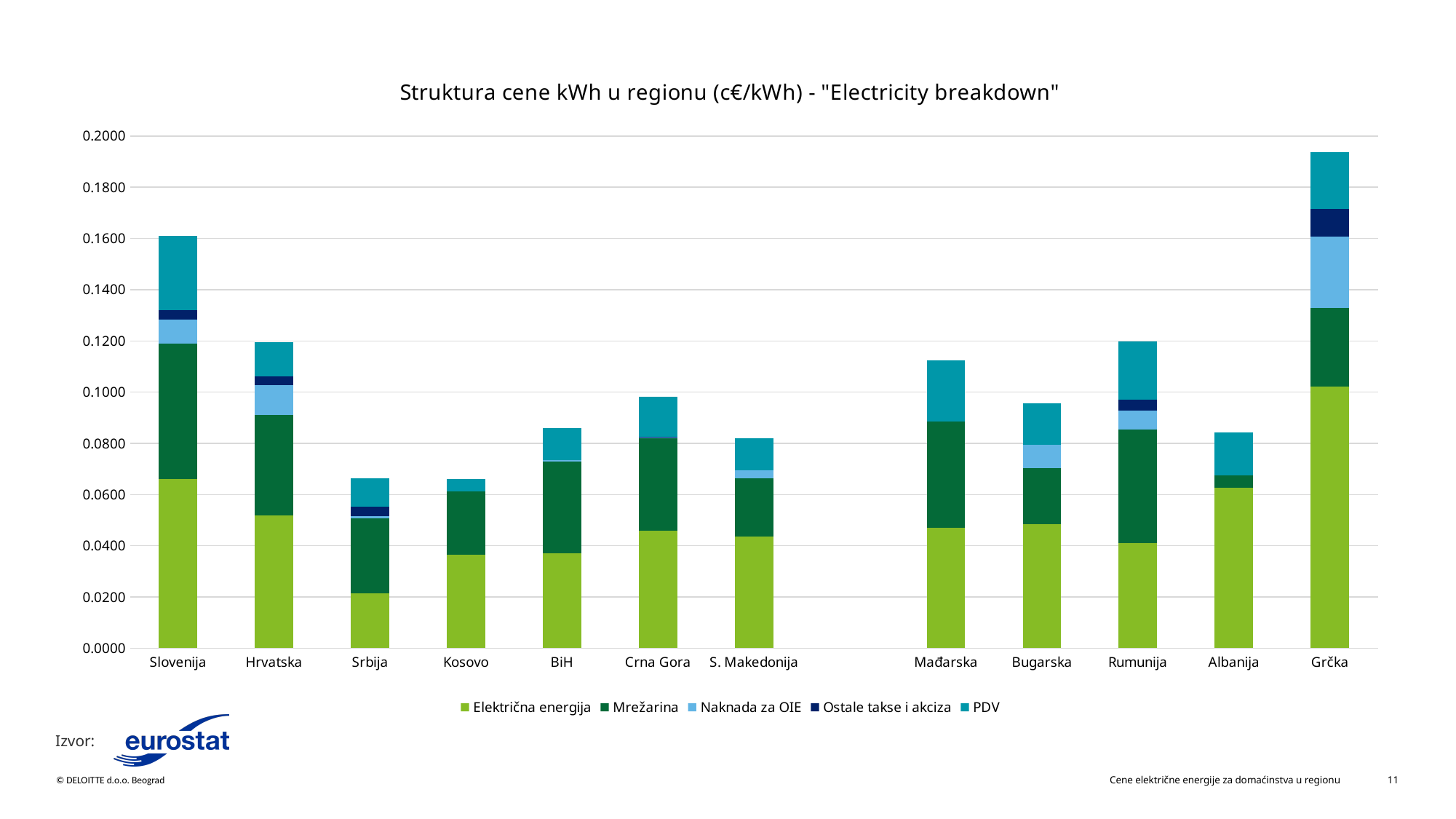
Is the total value for Albanija greater or less than 0.1000? less Which has the larger total stacked bar, Slovenija or Hrvatska? Slovenija Is the total value for Grčka greater or less than 0.1800? greater Which has the larger total stacked bar, Mađarska or Bugarska? Mađarska How many series does the legend list? 5 Which country has the highest total stacked bar? Grčka Is the total value for Mađarska greater or less than 0.1000? greater How many countries are shown on the x axis of the chart? 12 What is the title of the chart? Struktura cene kWh u regionu (c€/kWh) - "Electricity breakdown" What kind of chart is shown on the slide? Stacked bar chart